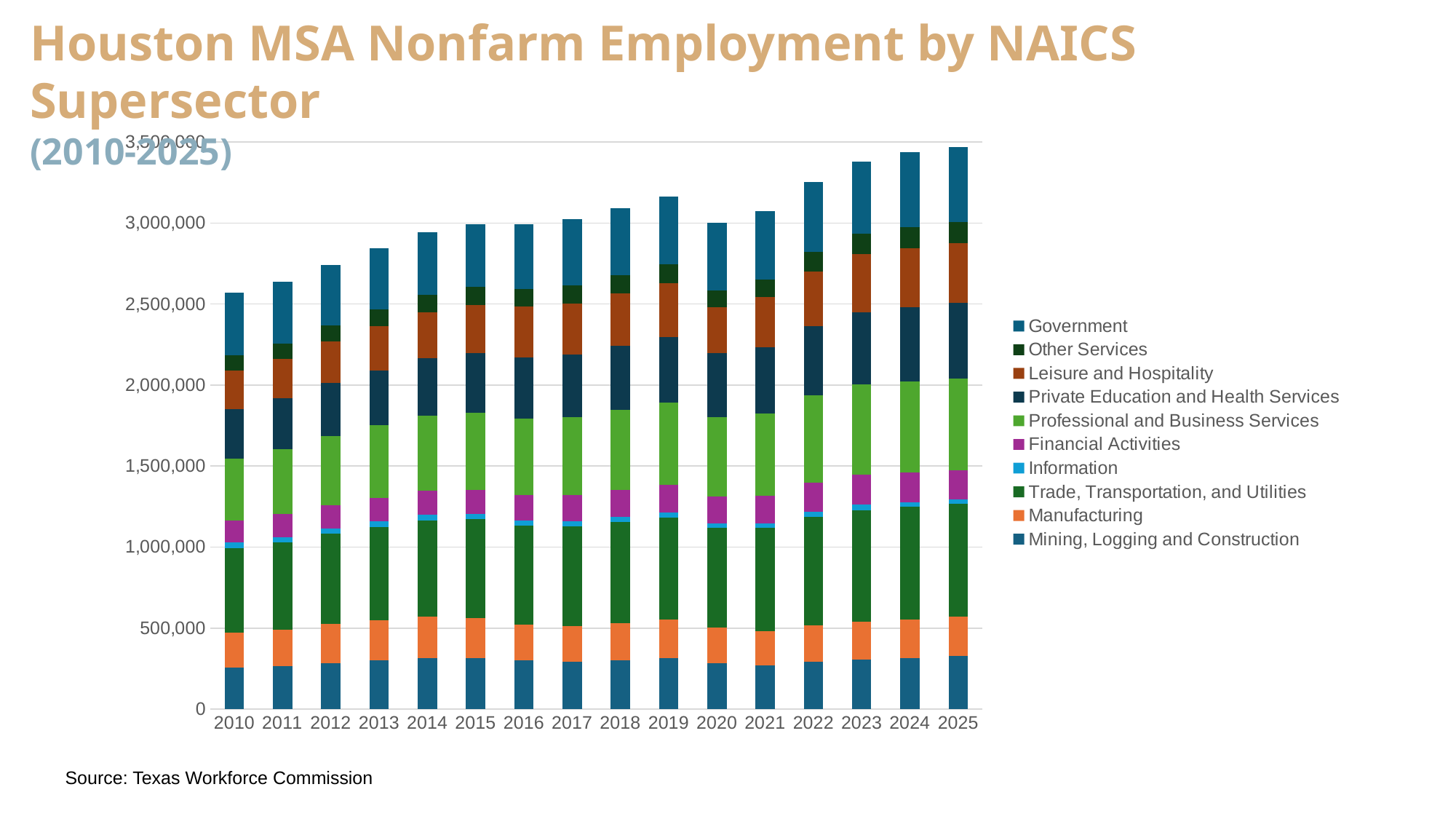
Is the total stacked bar for 2012 greater or less than 2,500,000? greater How many years are shown along the x axis of the chart? 16 How many series does the legend list? 10 Overall, do the total stacked bars rise or fall from 2010 to 2025? rise Is the total stacked bar for 2025 greater or less than 3,000,000? greater Which year has the shortest stacked bar (lowest total nonfarm employment)? 2010 Is the total stacked bar for 2010 greater or less than 3,000,000? less What kind of chart is shown on the slide? Stacked bar chart What source is cited for the chart data? Texas Workforce Commission Which year has the taller stacked bar, 2019 or 2020? 2019 Which year has the tallest stacked bar (highest total nonfarm employment)? 2025